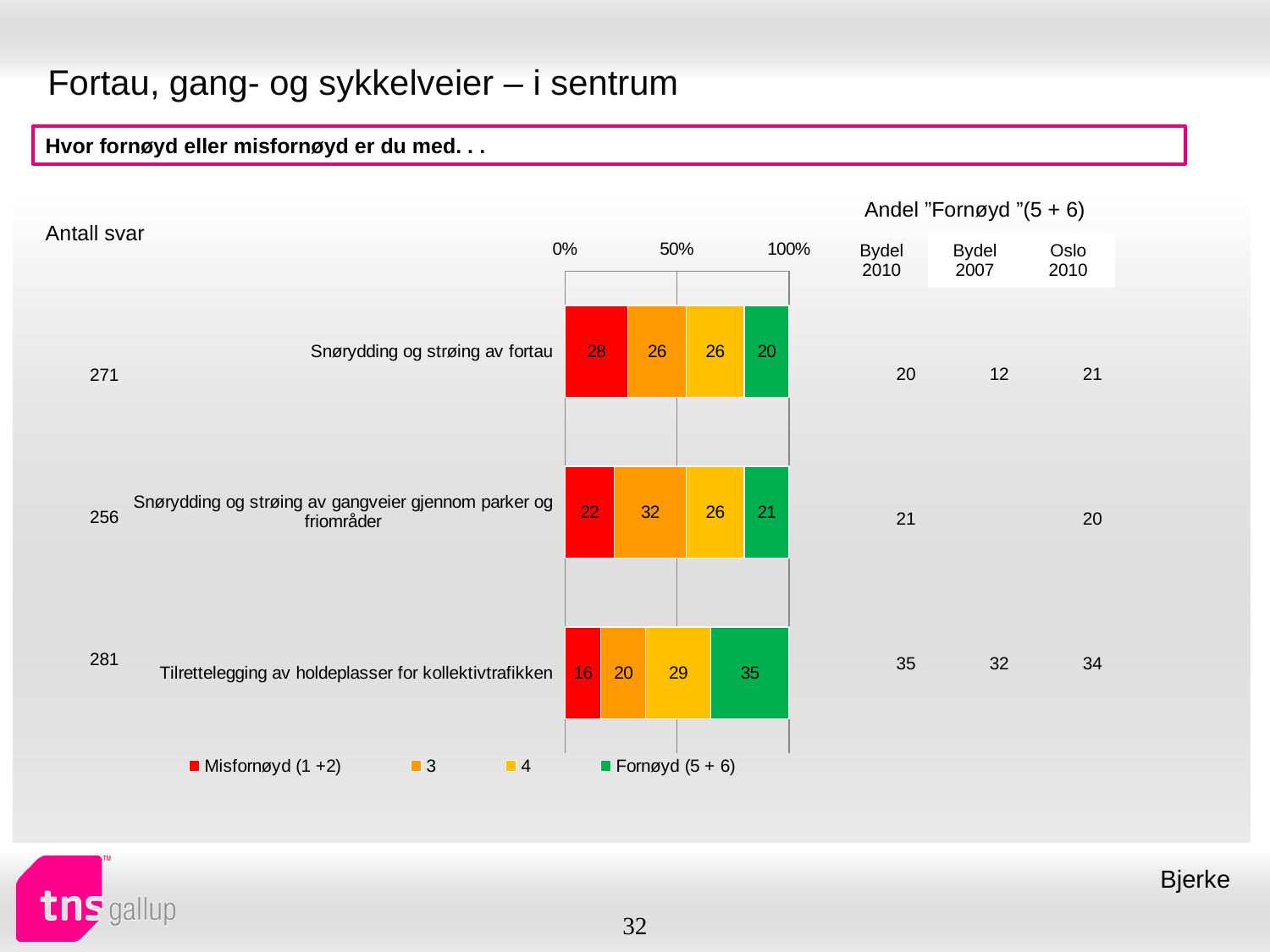
What is the value of the 'Fornøyd (5 + 6)' segment for 'Tilrettelegging av holdeplasser for kollektivtrafikken'? 35 What type of chart is shown on the slide? Stacked bar chart What is the difference between the 'Misfornøyd (1 +2)' values for 'Snørydding og strøing av fortau' and 'Tilrettelegging av holdeplasser for kollektivtrafikken'? 12 How many categories are plotted in the chart? 3 What is the value of the 'Misfornøyd (1 +2)' segment for 'Snørydding og strøing av fortau'? 28 Which is larger: the '4' segment for 'Tilrettelegging av holdeplasser for kollektivtrafikken' or the '4' segment for 'Snørydding og strøing av fortau'? Tilrettelegging av holdeplasser for kollektivtrafikken Which category has the lowest 'Misfornøyd (1 +2)' value? Tilrettelegging av holdeplasser for kollektivtrafikken Which legend entry is shown in red? Misfornøyd (1 +2) What is the total of the stacked bar for 'Snørydding og strøing av gangveier gjennom parker og friområder'? 101 Which category has the highest 'Fornøyd (5 + 6)' value? Tilrettelegging av holdeplasser for kollektivtrafikken What is the value of the '3' segment for 'Snørydding og strøing av gangveier gjennom parker og friområder'? 32 How many series does the chart legend list? 4